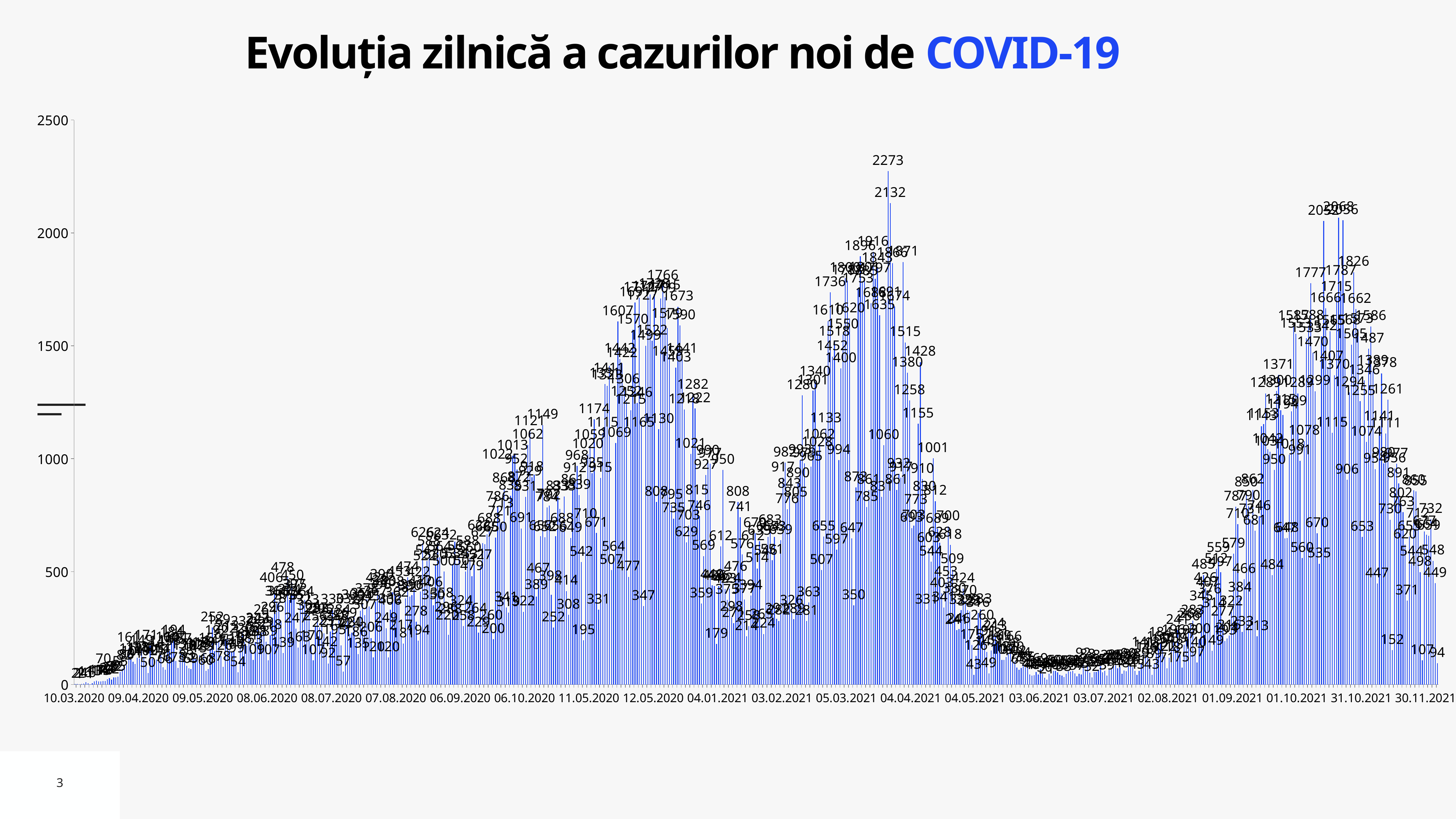
What is the title of the chart? Evoluția zilnică a cazurilor noi de COVID-19 What is the last date shown on the horizontal axis? 30.11.2021 What is the first date shown on the horizontal axis? 10.03.2020 Do the values generally rise or fall between 04.04.2021 and 03.06.2021? fall What is the difference between the two highest labelled values, 2273 and 2132? 141 Is the highest value on the chart greater or less than 2000? greater What kind of chart is shown on the slide? bar chart Around 03.07.2021, are the daily values greater or less than 500? less What is the highest tick value shown on the vertical axis? 2500 Do the values generally rise or fall between 10.03.2020 and 09.05.2020? rise What is the second-highest daily value labelled on the chart, just below the 2273 peak? 2132 What is the highest daily value labelled on the chart? 2273